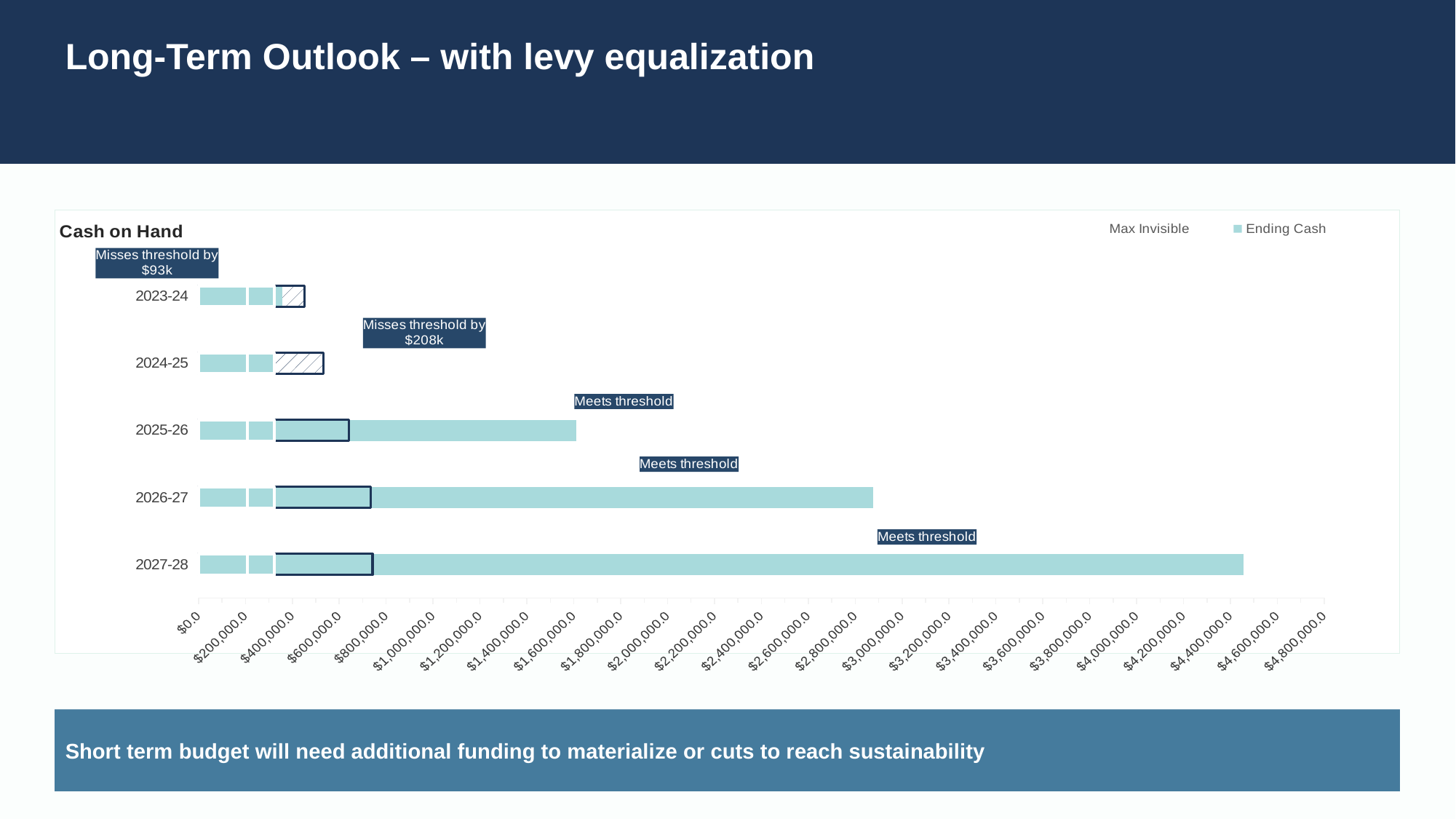
Which has the larger ending cash, 2026-27 or 2025-26? 2026-27 Is the ending cash for 2027-28 greater or less than $4,000,000.0? greater Is the ending cash for 2025-26 greater or less than $1,400,000.0? greater Do the ending cash values rise or fall from 2023-24 to 2027-28? rise What is the title of the chart? Cash on Hand By how much does 2024-25 miss the threshold, according to the annotation? $208k Which fiscal year has the highest ending cash? 2027-28 Is the ending cash for 2023-24 greater or less than $600,000.0? less What type of chart is shown on the slide? bar chart How many fiscal years are plotted on the chart? 5 How many series does the legend list? 2